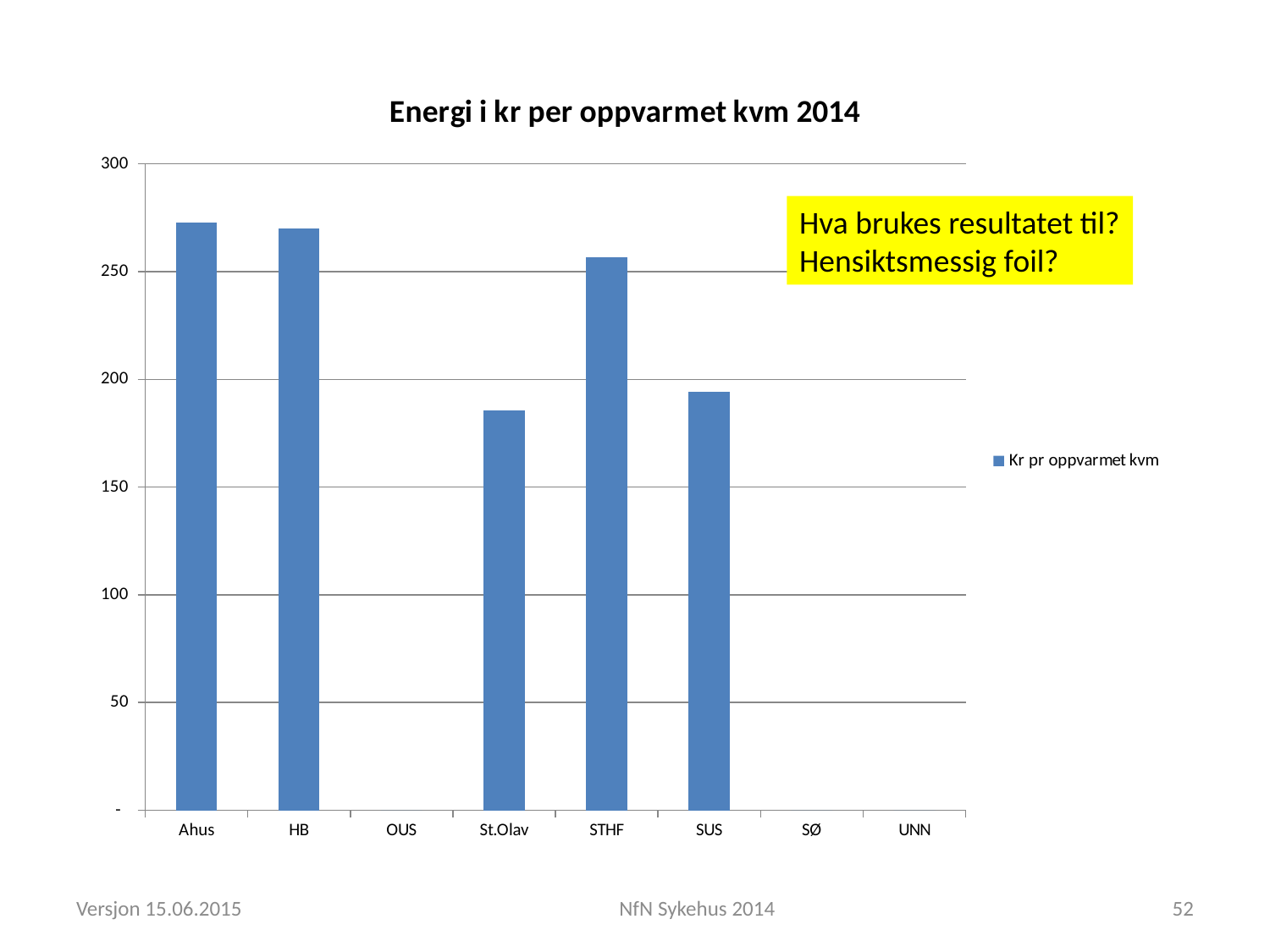
Is the value for SUS greater or less than 200? less Is the value for St.Olav greater or less than 200? less What kind of chart is shown on the slide? bar chart Which has the larger value, HB or St.Olav? HB Is the value for Ahus greater or less than 250? greater How many categories are shown on the x axis? 8 What is the title of the chart? Energi i kr per oppvarmet kvm 2014 How many series does the legend list? 1 Which has the larger value, STHF or SUS? STHF What is the legend entry for the series in the chart? Kr pr oppvarmet kvm